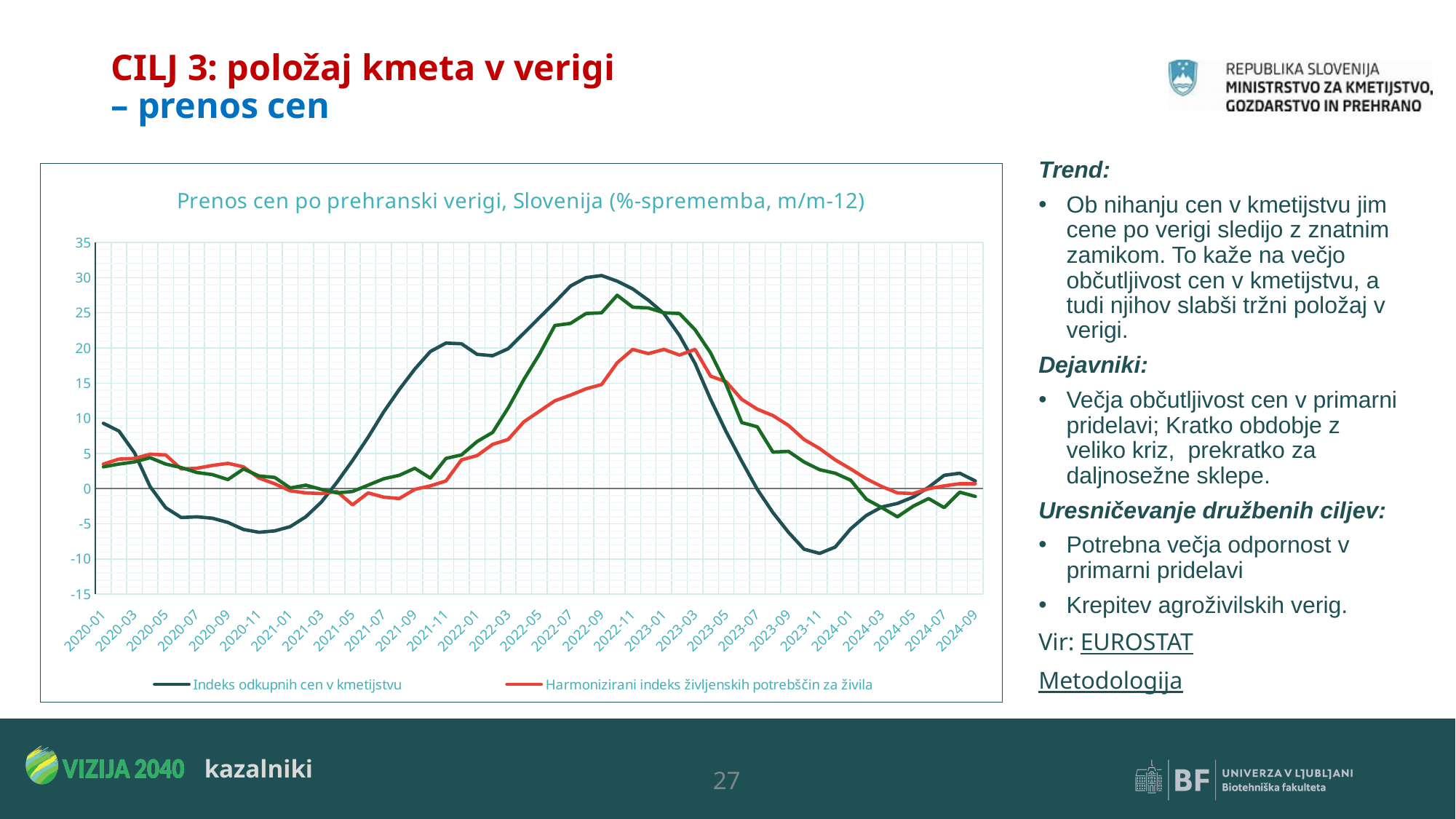
Does 'Indeks odkupnih cen v kmetijstvu' rise or fall between 2022-09 and 2023-11? fall Is the value of 'Indeks odkupnih cen v kmetijstvu' at 2023-11 greater or less than -5? less What kind of chart is shown on the slide? line chart What is the title of the chart? Prenos cen po prehranski verigi, Slovenija (%-sprememba, m/m-12) Which colour is used for the series 'Harmonizirani indeks življenskih potrebščin za živila'? red Is the value of 'Indeks odkupnih cen v kmetijstvu' at 2022-09 greater or less than 25? greater How many series does the chart's legend list? 2 At 2022-09, which series is higher: 'Indeks odkupnih cen v kmetijstvu' or 'Harmonizirani indeks življenskih potrebščin za živila'? Indeks odkupnih cen v kmetijstvu Is the value of 'Harmonizirani indeks življenskih potrebščin za živila' at 2022-11 greater or less than 15? greater At 2023-09, which series is higher: 'Indeks odkupnih cen v kmetijstvu' or 'Harmonizirani indeks življenskih potrebščin za živila'? Harmonizirani indeks življenskih potrebščin za živila